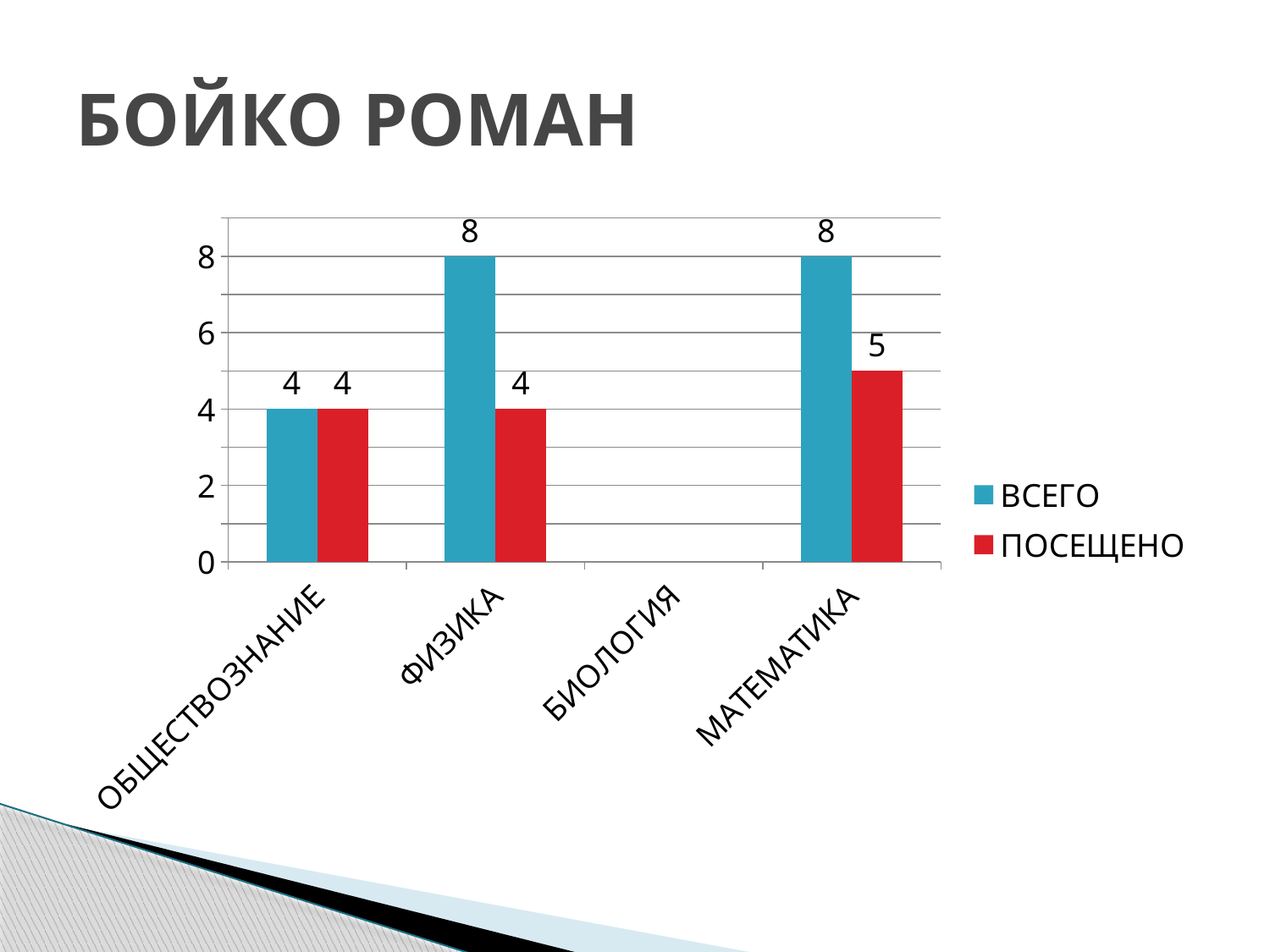
What is the ВСЕГО value for МАТЕМАТИКА? 8 How many series does the legend list? 2 Which is larger for ФИЗИКА, the ВСЕГО value or the ПОСЕЩЕНО value? ВСЕГО What is the difference between the ВСЕГО and ПОСЕЩЕНО values for МАТЕМАТИКА? 3 Which category has the highest ПОСЕЩЕНО value? МАТЕМАТИКА How many categories are shown on the x axis? 4 What is the ВСЕГО value for ФИЗИКА? 8 What kind of chart is shown on the slide? bar chart Which colour represents the ПОСЕЩЕНО series? red What is the ПОСЕЩЕНО value for ОБЩЕСТВОЗНАНИЕ? 4 What is the difference between the ВСЕГО and ПОСЕЩЕНО values for ФИЗИКА? 4 What is the ПОСЕЩЕНО value for МАТЕМАТИКА? 5